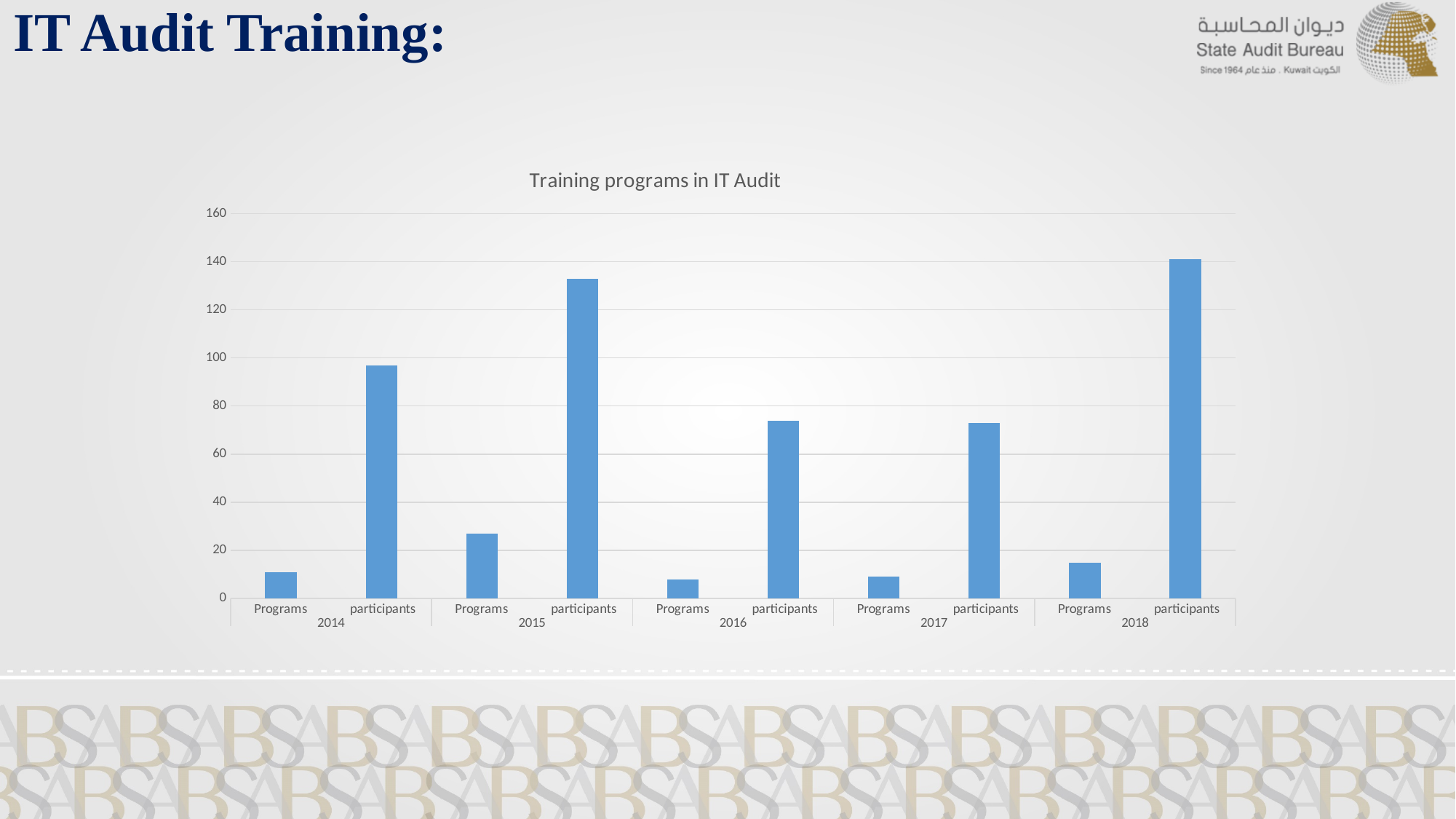
Is the value for participants in 2015 greater or less than 120? greater Which is larger, participants in 2014 or participants in 2015? participants in 2015 What is the title of the chart? Training programs in IT Audit Is the value for participants in 2016 greater or less than 80? less How many bars are plotted in the chart? 10 Is the value for Programs in 2014 greater or less than 20? less Which bar is the highest in the chart? participants 2018 How many years are shown along the x axis of the chart? 5 What type of chart is shown on the slide? Bar chart Did the number of participants rise or fall from 2015 to 2016? fall